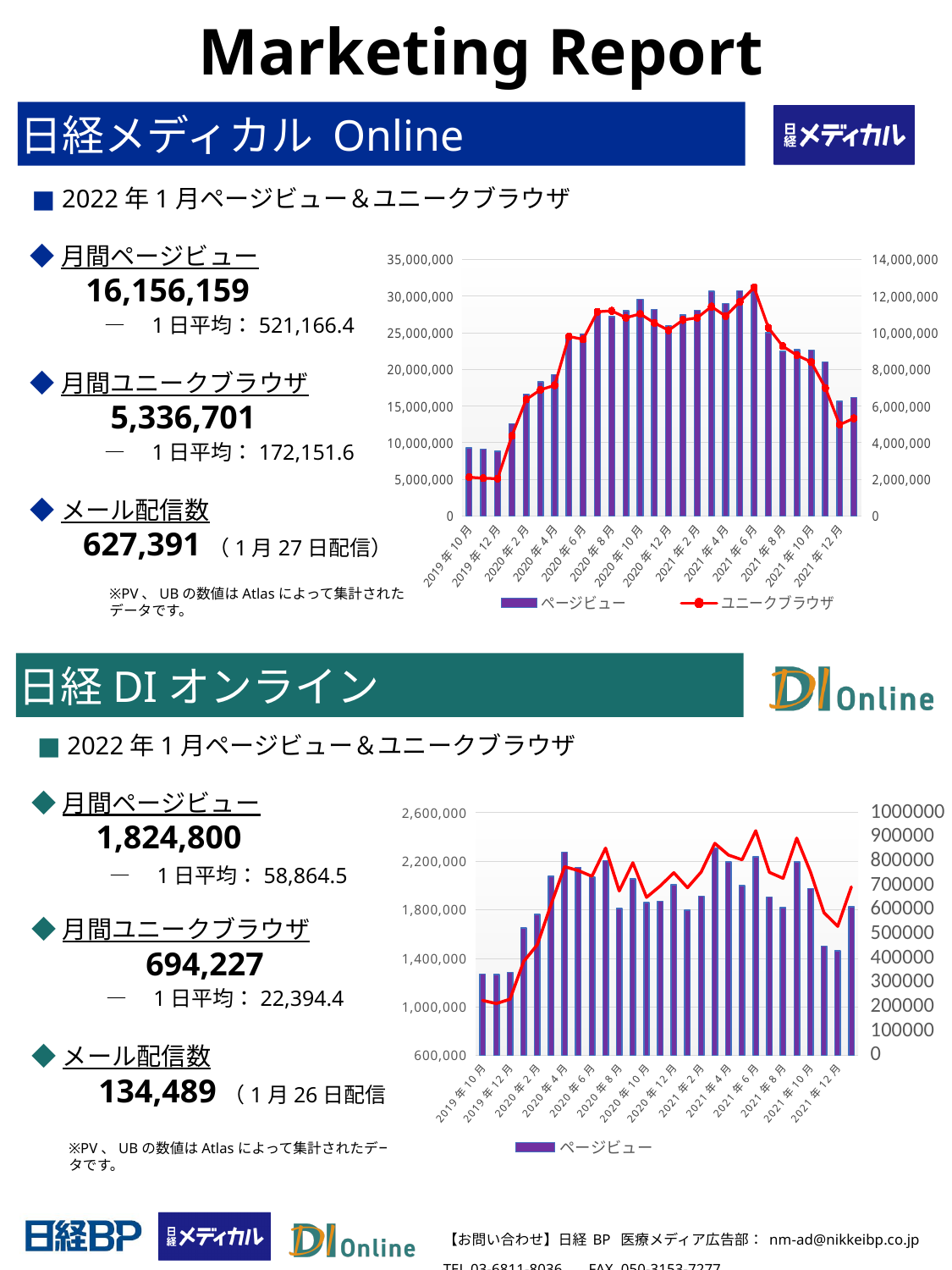
On the 日経メディカル Online chart, is the ページビュー value for 2019年12月 greater or less than 10,000,000? less On the 日経メディカル Online chart, what are the two legend entries? ページビュー and ユニークブラウザ On the 日経メディカル Online chart, do the ページビュー bars rise or fall from 2019年10月 to 2020年4月? rise On the 日経メディカル Online chart, which is larger, the ページビュー bar for 2020年10月 or for 2020年2月? 2020年10月 On the 日経 DI オンライン chart, is the ページビュー value for 2019年10月 greater or less than 1,400,000? less On the 日経 DI オンライン chart, is the ページビュー value for 2020年4月 greater or less than 2,200,000? greater On the 日経 DI オンライン chart, which is larger, the ページビュー bar for 2020年4月 or for 2021年12月? 2020年4月 On the 日経メディカル Online chart, how many series does the legend list? 2 On the 日経 DI オンライン chart, how many entries does the legend list? 1 What kind of chart is the 日経メディカル Online chart? bar chart with a line